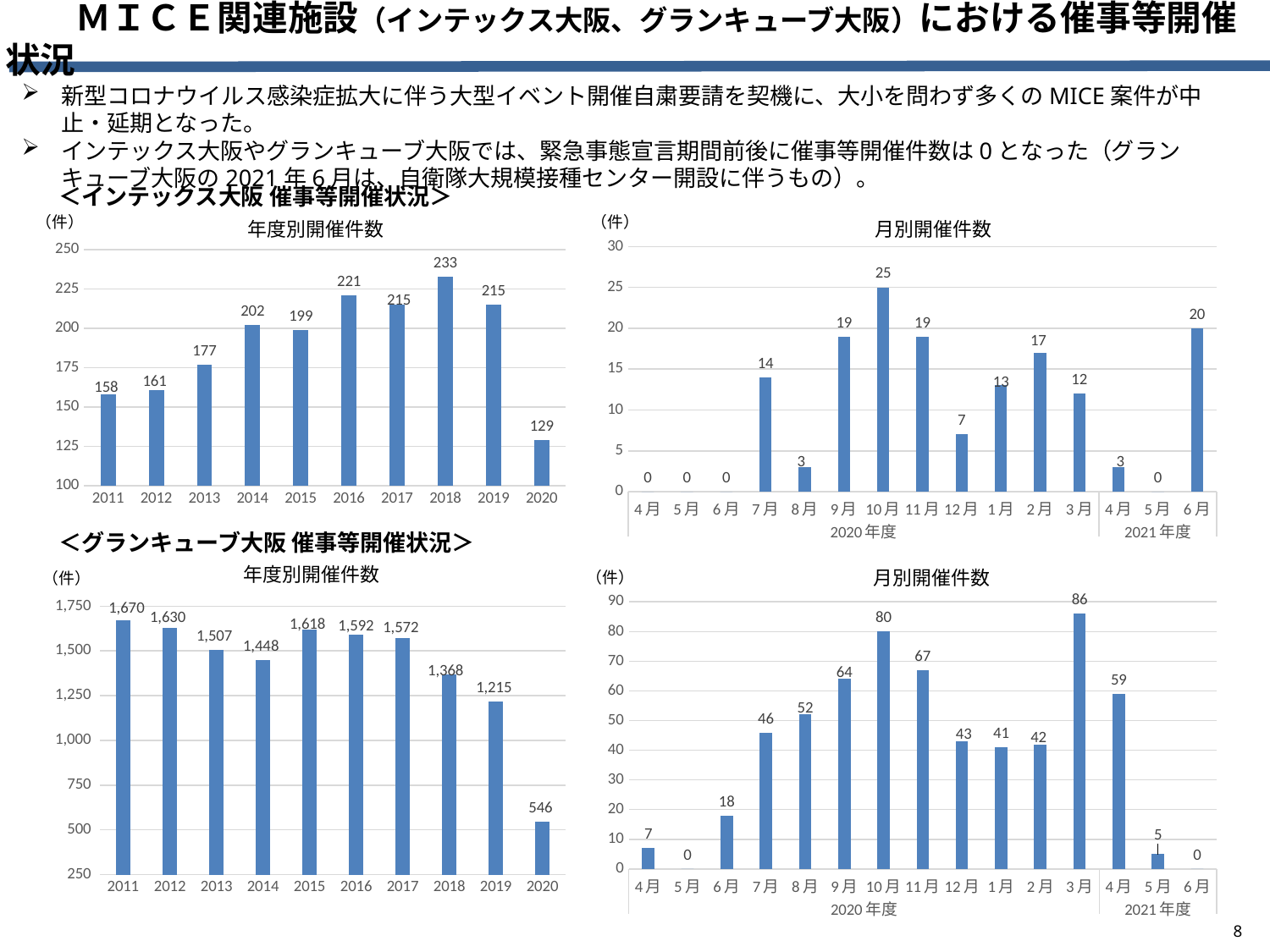
What type of chart is the bottom-right chart (グランキューブ大阪 月別開催件数)? Bar chart In the bottom-right chart (グランキューブ大阪 月別開催件数), what is the value for 3月? 86 In the top-left chart (インテックス大阪 年度別開催件数), which year has the lowest value? 2020 In the bottom-left chart (グランキューブ大阪 年度別開催件数), what is the value for 2011? 1,670 In the bottom-left chart (グランキューブ大阪 年度別開催件数), which is larger, the value for 2015 or the value for 2016? 2015 In the top-right chart (インテックス大阪 月別開催件数), which month has the highest value? 10月 In the top-right chart (インテックス大阪 月別開催件数), how many months are shown on the x axis? 15 In the top-left chart (インテックス大阪 年度別開催件数), what is the difference between the values for 2019 and 2020? 86 In the bottom-left chart (グランキューブ大阪 年度別開催件数), what is the difference between the values for 2019 and 2020? 669 In the top-right chart (インテックス大阪 月別開催件数), what is the value for 6月 of 2021年度? 20 In the top-left chart (インテックス大阪 年度別開催件数), what is the value for 2018? 233 In the bottom-right chart (グランキューブ大阪 月別開催件数), which is larger, the value for 12月 or the value for 1月? 12月